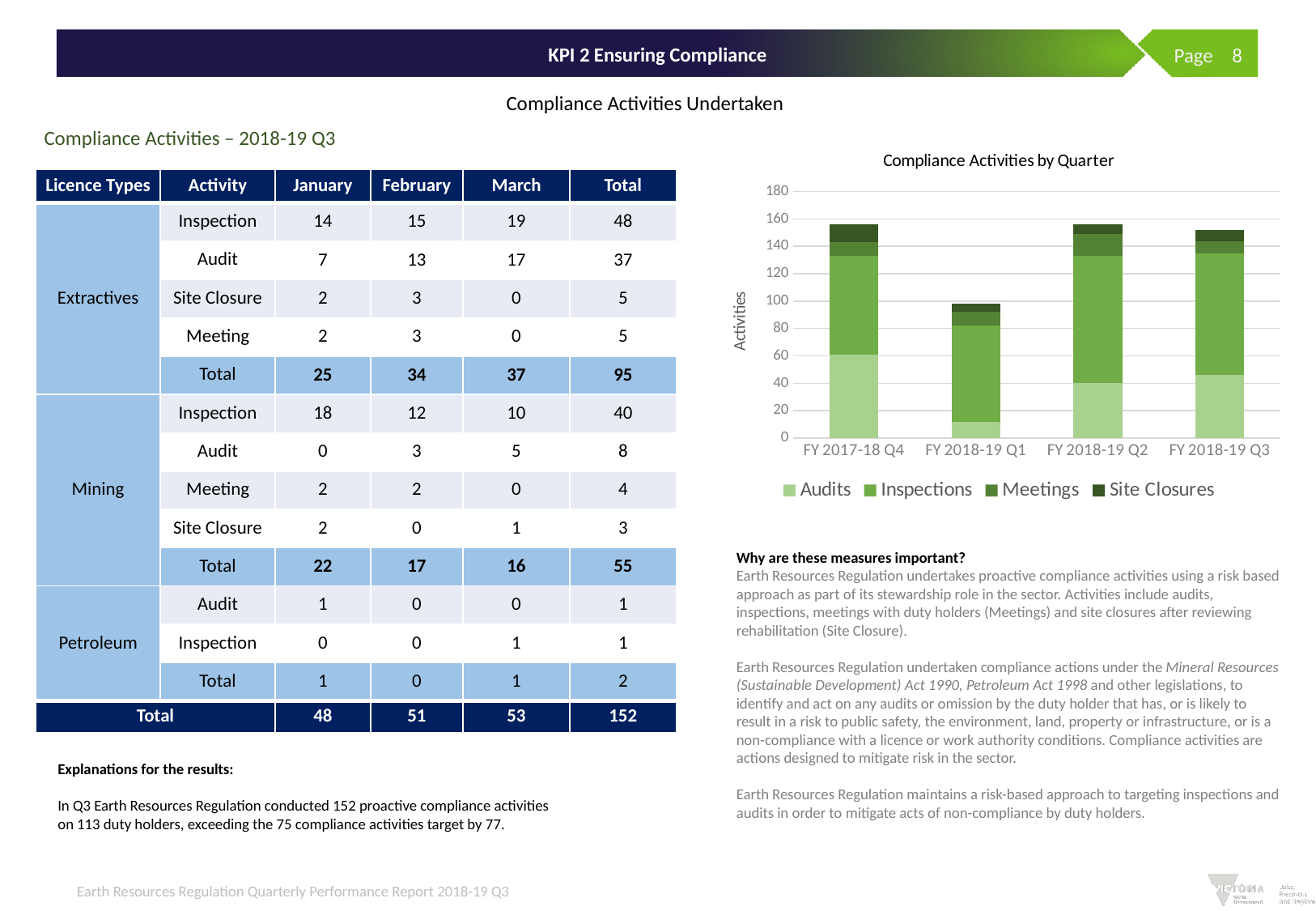
In the Compliance Activities by Quarter chart, which quarter has the lowest total bar? FY 2018-19 Q1 In the Compliance Activities by Quarter chart, is the Audits segment for FY 2017-18 Q4 greater or less than 40? greater In the Compliance Activities by Quarter chart, which has the larger Audits segment, FY 2018-19 Q2 or FY 2018-19 Q3? FY 2018-19 Q3 How many series does the legend of the Compliance Activities by Quarter chart list? 4 In the Compliance Activities by Quarter chart, is the total bar for FY 2017-18 Q4 greater or less than 140? greater What is the title of the chart on the slide? Compliance Activities by Quarter In the Compliance Activities by Quarter chart, is the Audits segment for FY 2018-19 Q1 greater or less than 20? less What kind of chart is the Compliance Activities by Quarter chart? Stacked bar chart How many quarters are shown on the x axis of the Compliance Activities by Quarter chart? 4 In the Compliance Activities by Quarter chart, which has the taller total bar, FY 2018-19 Q1 or FY 2018-19 Q3? FY 2018-19 Q3 Which series are listed in the legend of the Compliance Activities by Quarter chart? Audits, Inspections, Meetings, Site Closures